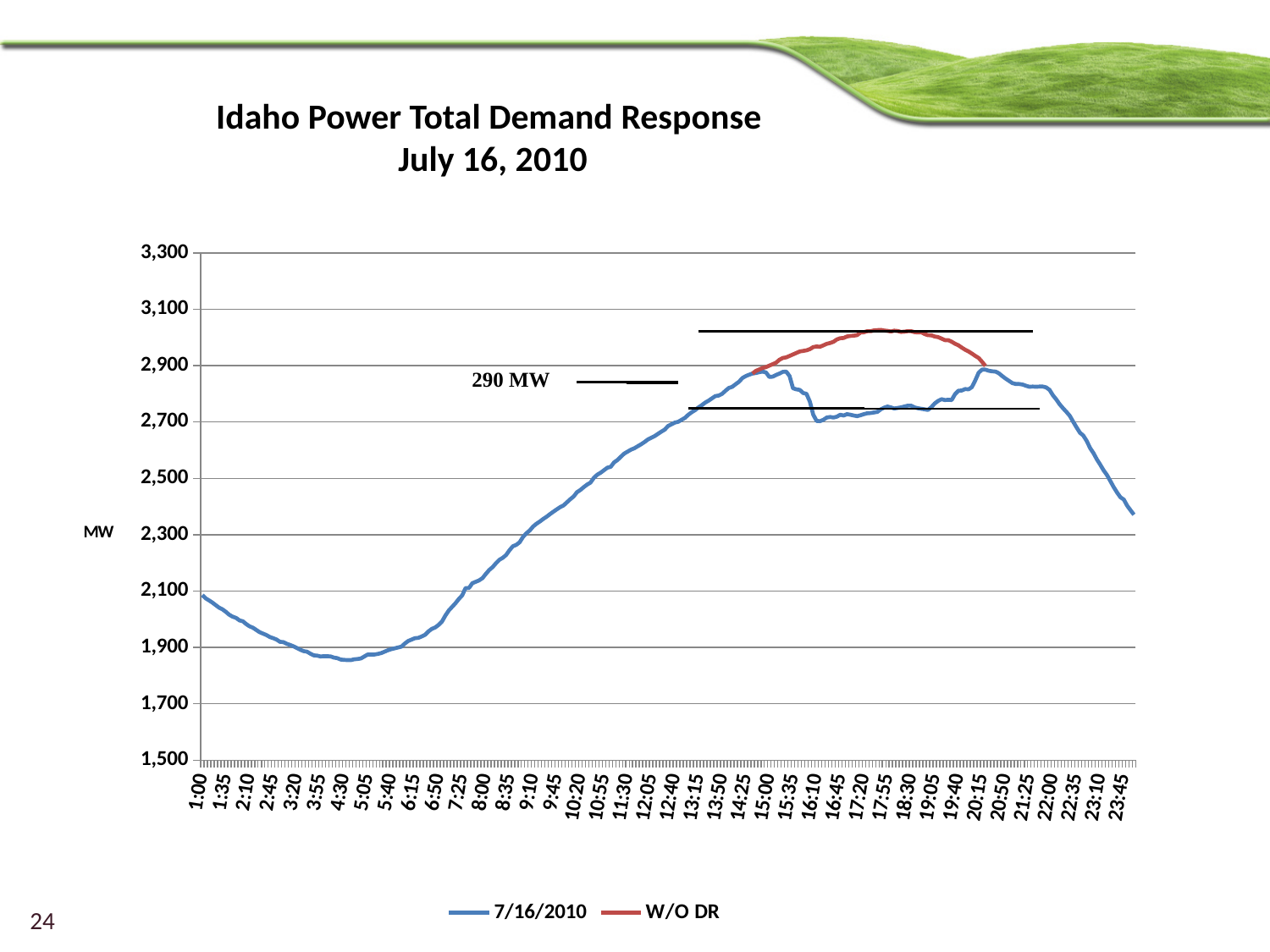
What kind of chart is shown on the slide? line chart Does the 7/16/2010 line rise or fall between 5:40 and 14:25? rise Does the 7/16/2010 line rise or fall between 22:00 and 23:45? fall At 17:55, which series has the higher value, 7/16/2010 or W/O DR? W/O DR How many series does the legend list? 2 Is the value of the 7/16/2010 line at 16:10 greater or less than 2,900? less Is the value of the 7/16/2010 line at 23:45 greater or less than 2,500? less Is the value of the 7/16/2010 line at 10:55 greater or less than 2,300? greater What are the two series named in the legend? 7/16/2010 and W/O DR What value is written in the annotation between the two horizontal reference lines? 290 MW